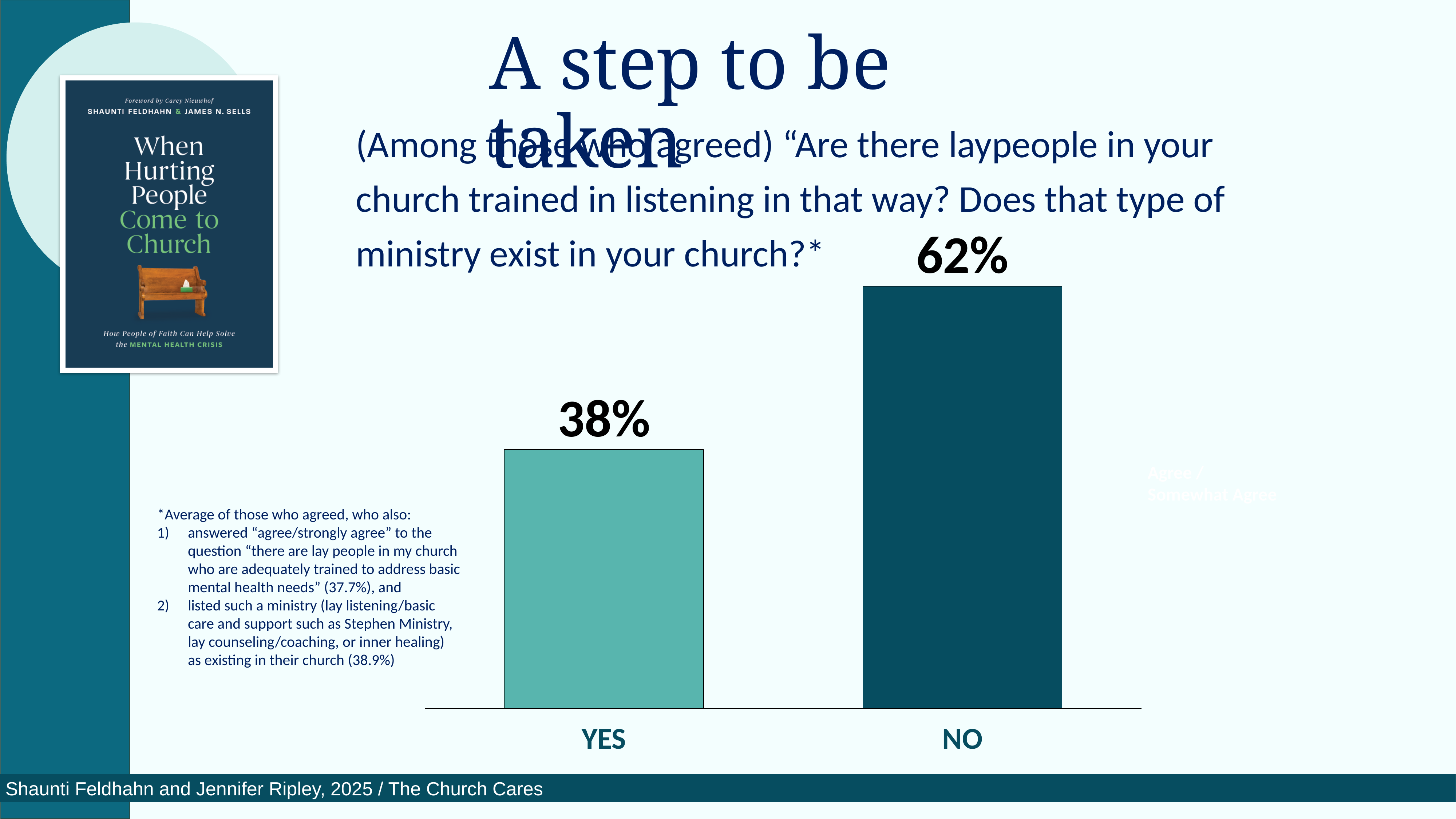
What is the difference between the NO and YES values? 24% Which is larger, the value for YES or the value for NO? NO What kind of chart is shown on the slide? bar chart Which bar is drawn in the darker teal colour? NO Do the values rise or fall from YES to NO along the x axis? rise Which category has the lowest value? YES How many categories are shown in the chart? 2 What is the value for YES? 38% What is the value for NO? 62% What is the total of the YES and NO values? 100% Which category has the highest value? NO